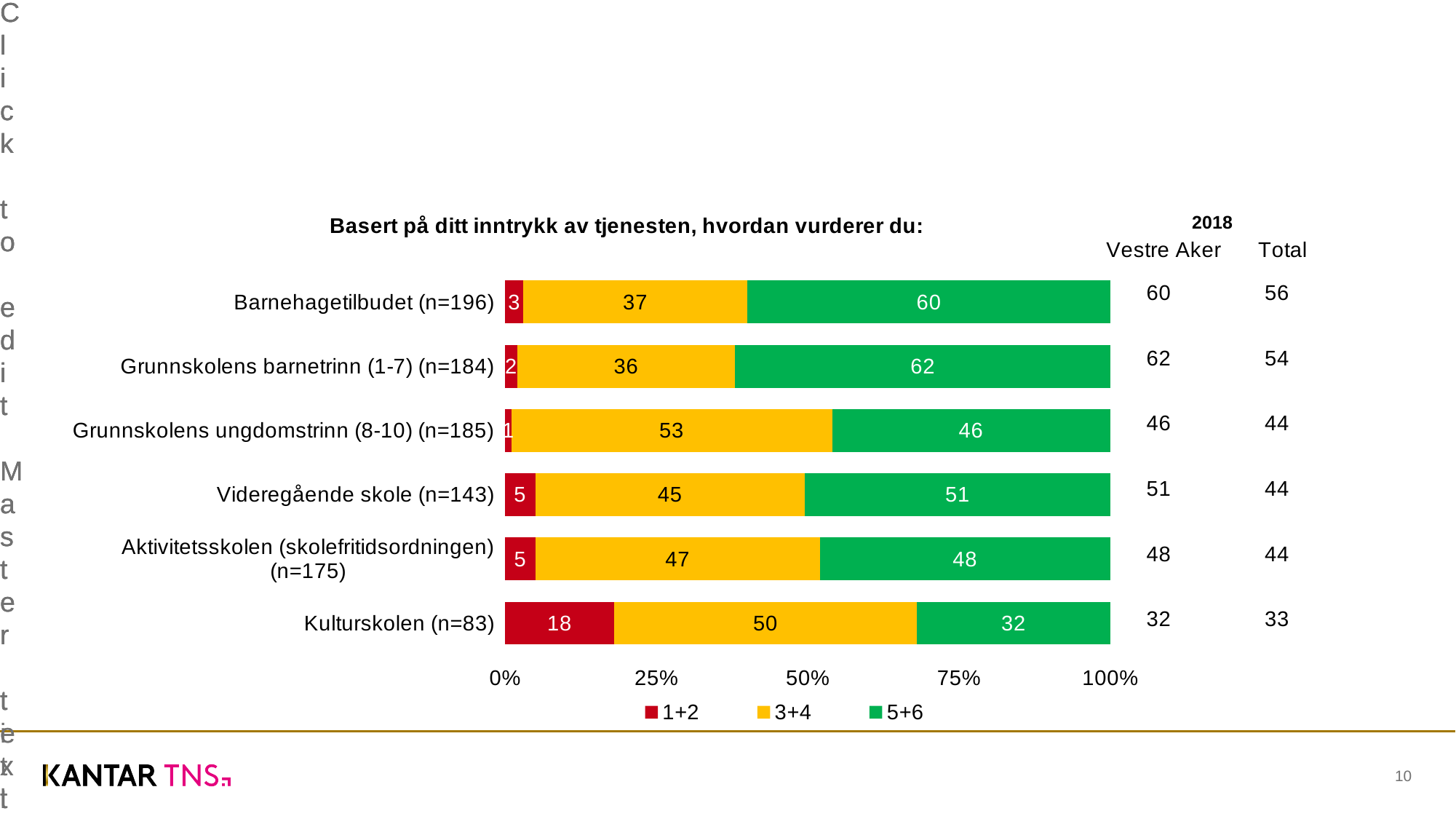
What is the 5+6 value for Barnehagetilbudet (n=196)? 60 Which category has the highest 5+6 value? Grunnskolens barnetrinn (1-7) (n=184) Which category has the lowest 5+6 value? Kulturskolen (n=83) What is the difference between the 5+6 values for Barnehagetilbudet (n=196) and Kulturskolen (n=83)? 28 Which is larger: the 3+4 value for Videregående skole (n=143) or for Aktivitetsskolen (skolefritidsordningen) (n=175)? Aktivitetsskolen (skolefritidsordningen) (n=175) What is the total of the stacked bar for Kulturskolen (n=83)? 100 What kind of chart is shown on the slide? Stacked bar chart How many categories are shown in the chart? 6 What is the title of the chart? Basert på ditt inntrykk av tjenesten, hvordan vurderer du: How many series does the legend list? 3 What is the 3+4 value for Grunnskolens ungdomstrinn (8-10) (n=185)? 53 What is the 1+2 value for Kulturskolen (n=83)? 18